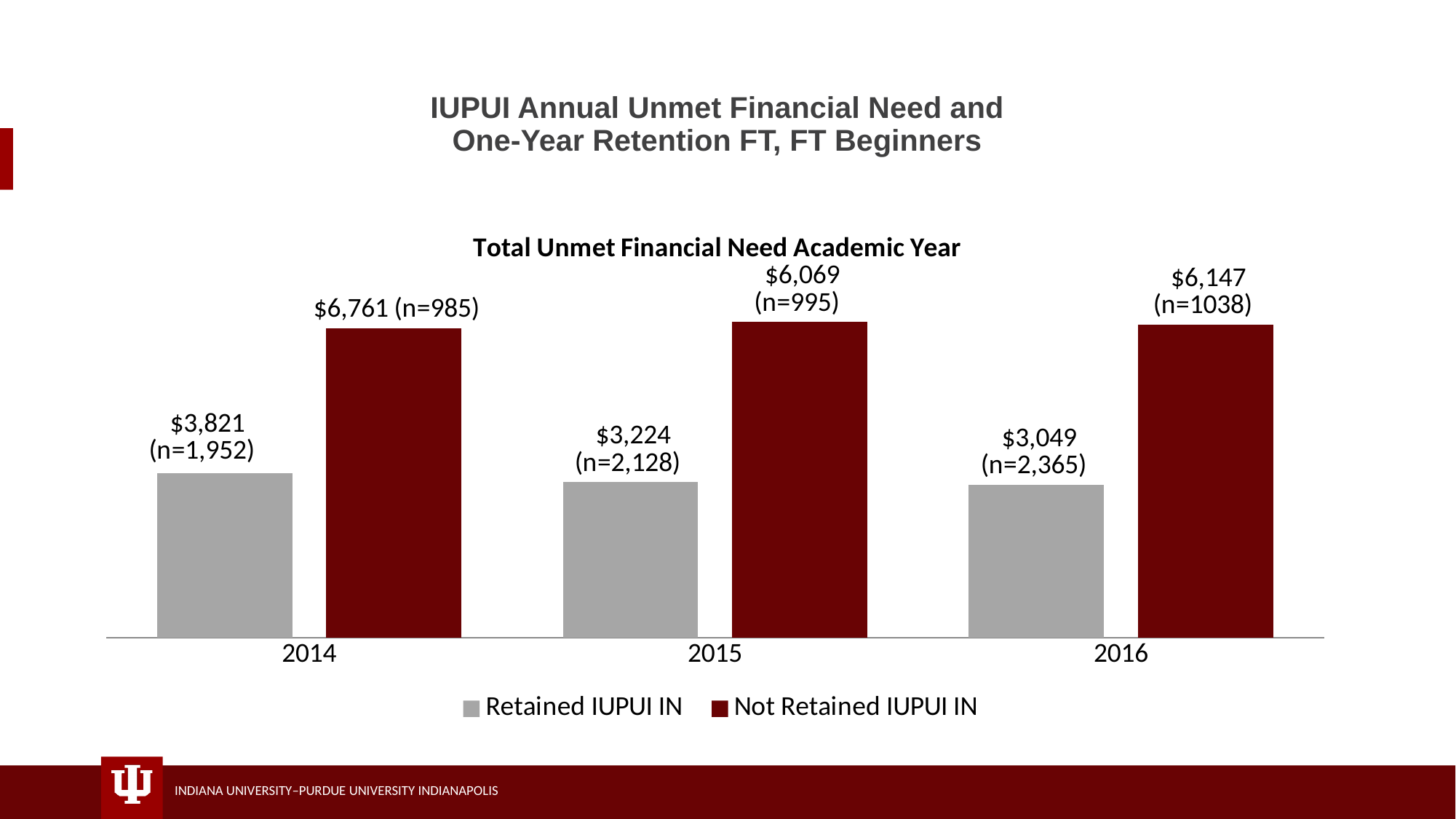
What is the difference between the Not Retained and Retained unmet financial need in 2014? $2,940 How many years are shown on the x axis of the chart? 3 In which year is the unmet financial need for Not Retained IUPUI IN students highest? 2014 What is the total unmet financial need for Retained IUPUI IN students in 2014? $3,821 Does the unmet financial need for Retained IUPUI IN students rise or fall from 2014 to 2016? Fall What is the total unmet financial need for Not Retained IUPUI IN students in 2015? $6,069 What kind of chart is shown on the slide? Bar chart What is the n value shown for Retained IUPUI IN students in 2016? n=2,365 What is the total unmet financial need for Not Retained IUPUI IN students in 2016? $6,147 In which year is the unmet financial need for Retained IUPUI IN students lowest? 2016 Which is larger in 2015: the unmet financial need for Retained IUPUI IN or Not Retained IUPUI IN students? Not Retained IUPUI IN How many series does the legend list? 2